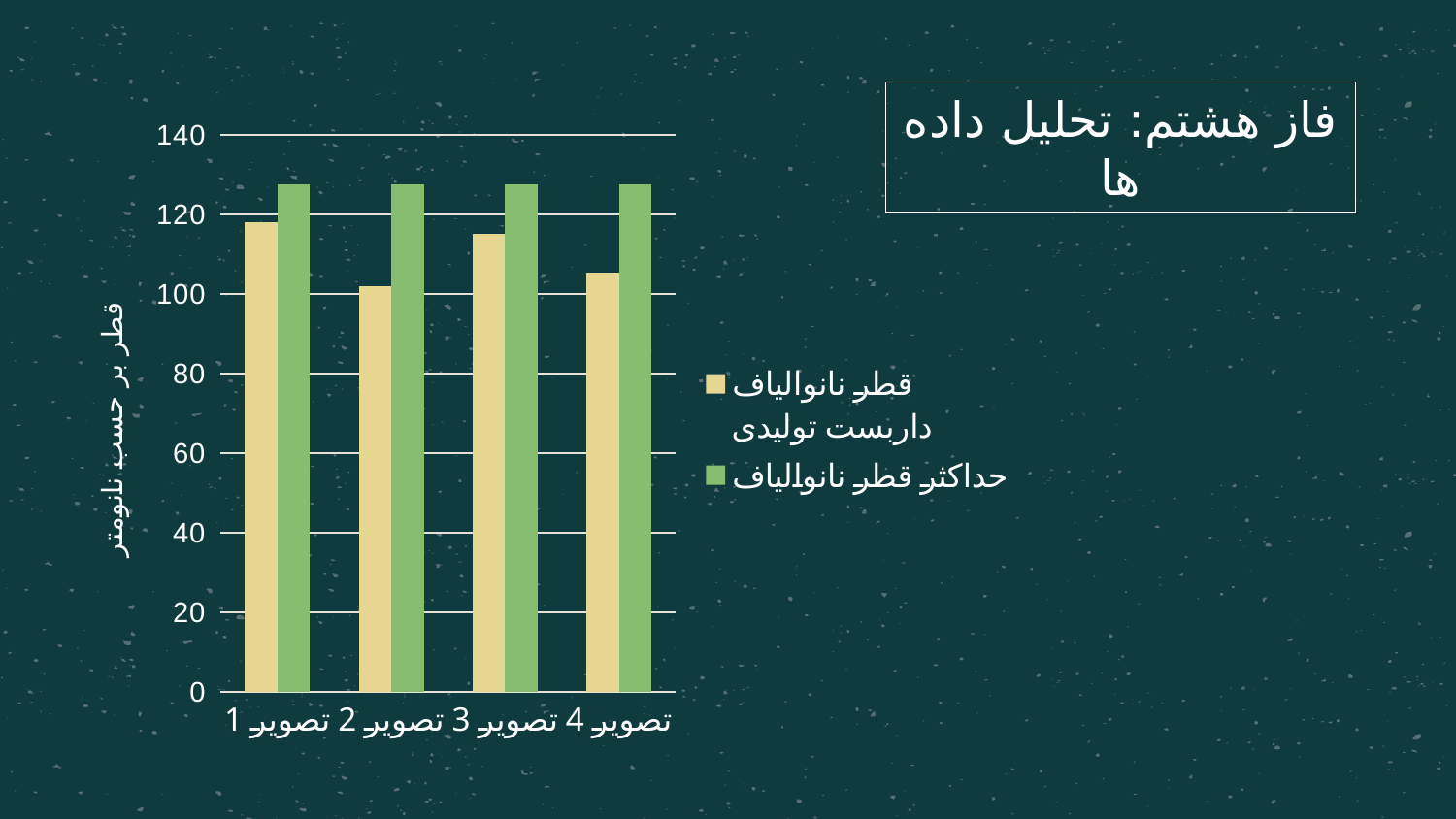
How many categories are shown on the x axis? 4 Is the value of حداکثر قطر نانوالیاف for تصویر 3 greater or less than 140? less Is the value of قطر نانوالیاف داربست تولیدی for تصویر 2 greater or less than 120? less What is the label on the y axis of the chart? قطر بر حسب نانومتر Is the value of حداکثر قطر نانوالیاف for تصویر 1 greater or less than 120? greater For تصویر 2, which series has the larger value: قطر نانوالیاف داربست تولیدی or حداکثر قطر نانوالیاف? حداکثر قطر نانوالیاف Which category has the lowest value for قطر نانوالیاف داربست تولیدی? تصویر 2 What kind of chart is shown on the slide? bar chart Which is larger: the value of قطر نانوالیاف داربست تولیدی for تصویر 1 or for تصویر 2? تصویر 1 How many series does the legend list? 2